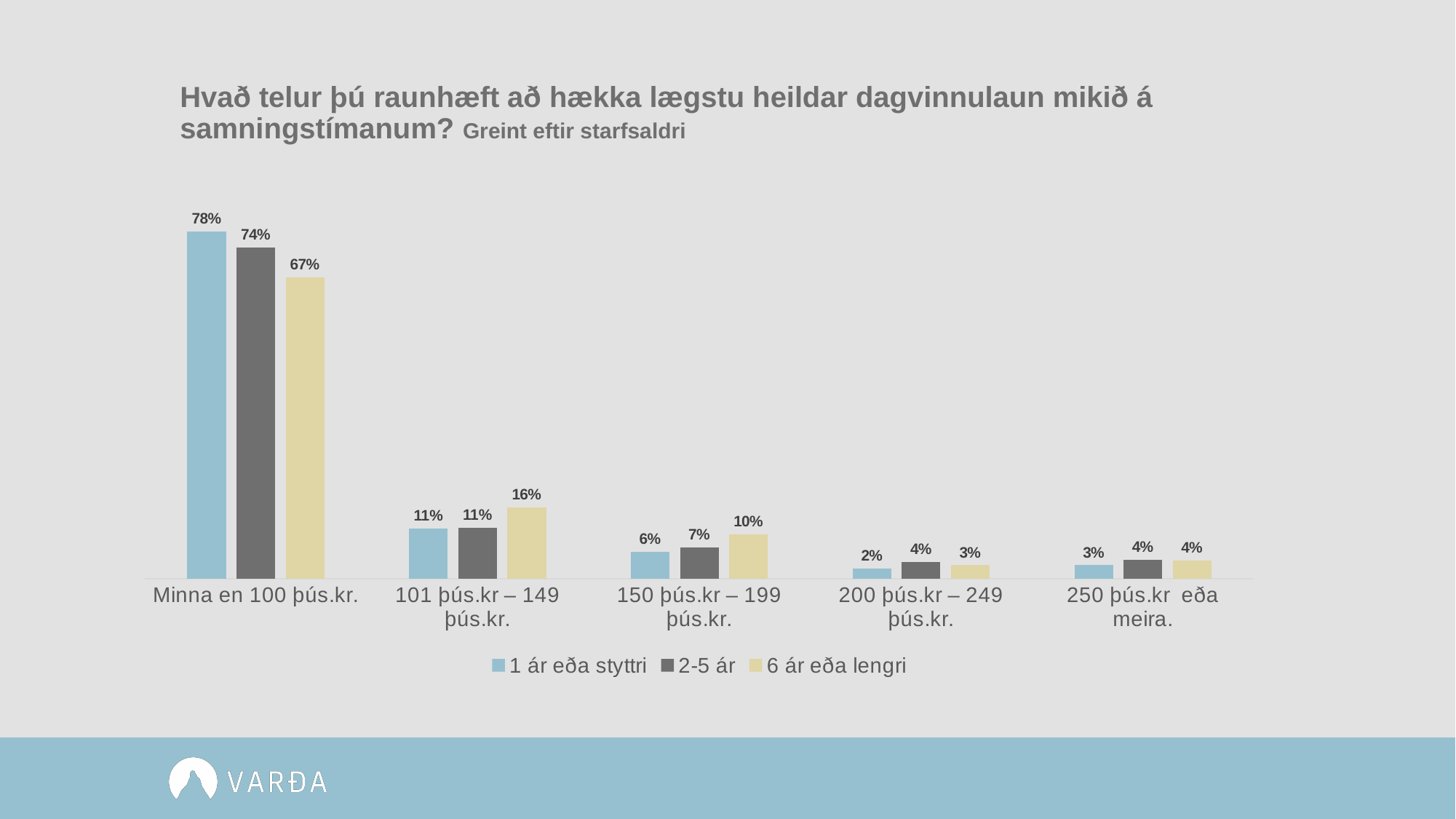
What is the value for '2-5 ár' in the '150 þús.kr – 199 þús.kr.' category? 7% What is the value for '6 ár eða lengri' in the '101 þús.kr – 149 þús.kr.' category? 16% Which category has the highest value for the '2-5 ár' series? Minna en 100 þús.kr. What kind of chart is shown on the slide? Bar chart In the '150 þús.kr – 199 þús.kr.' category, which series has the larger value: '1 ár eða styttri' or '6 ár eða lengri'? 6 ár eða lengri What is the value for '1 ár eða styttri' in the '200 þús.kr – 249 þús.kr.' category? 2% What is the difference between the '1 ár eða styttri' and '6 ár eða lengri' values in the 'Minna en 100 þús.kr.' category? 11% How many series does the legend list? 3 Which category has the lowest value for the '1 ár eða styttri' series? 200 þús.kr – 249 þús.kr. Which series is shown in yellow in the legend? 6 ár eða lengri How many categories are shown on the x axis? 5 What is the value for '1 ár eða styttri' in the 'Minna en 100 þús.kr.' category? 78%